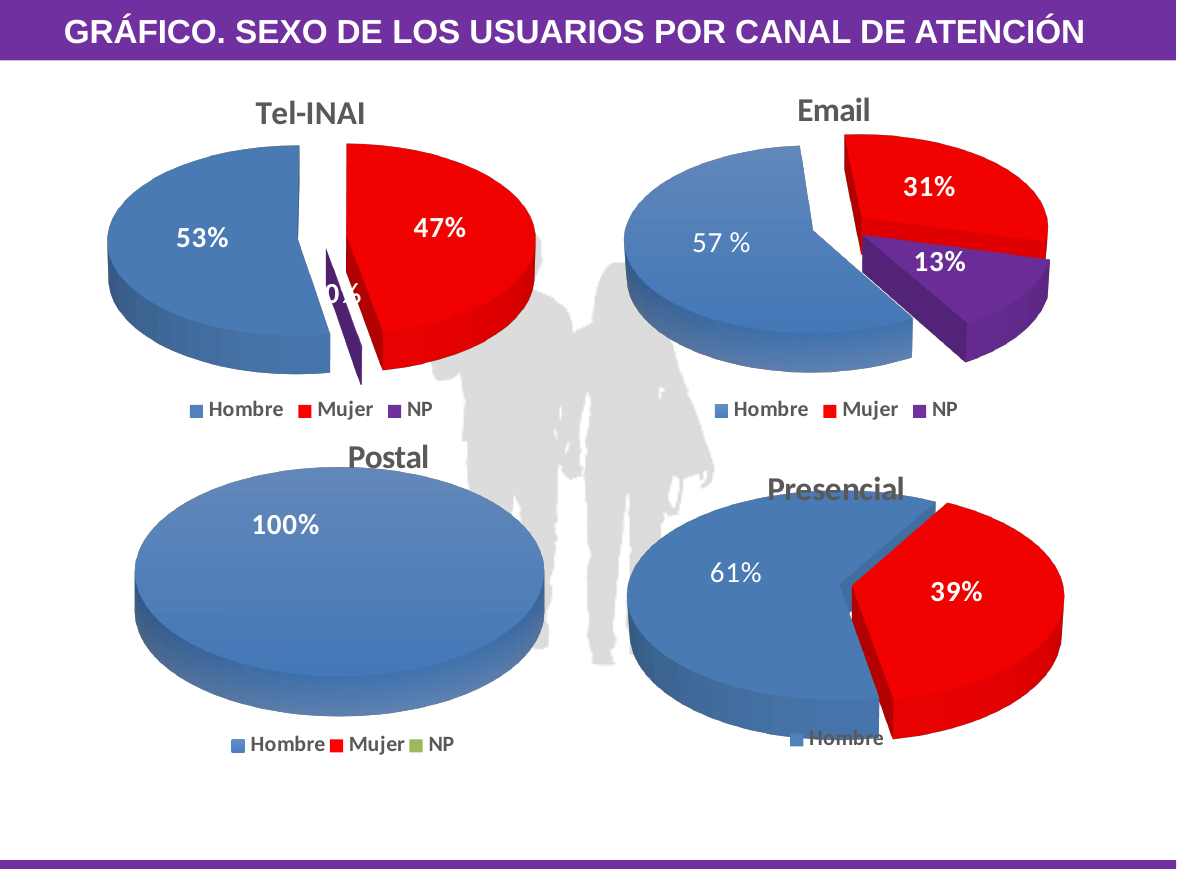
In the Presencial chart, which category has the largest share? Hombre In the Tel-INAI chart, what share of users are Hombre? 53% In the Email chart, what share of users are NP? 13% In the Email chart, what share of users are Mujer? 31% In the Postal chart, what share of users are Hombre? 100% In the Tel-INAI chart, which is larger, the Hombre share or the Mujer share? Hombre In the Presencial chart, what share of users are Hombre? 61% In the Tel-INAI chart, what share of users are Mujer? 47% How many entries does the legend of the Tel-INAI chart list? 3 What type of chart is the Email chart? Pie chart In the Presencial chart, what is the difference between the Hombre and Mujer shares? 22% In the Email chart, which category has the smallest share? NP